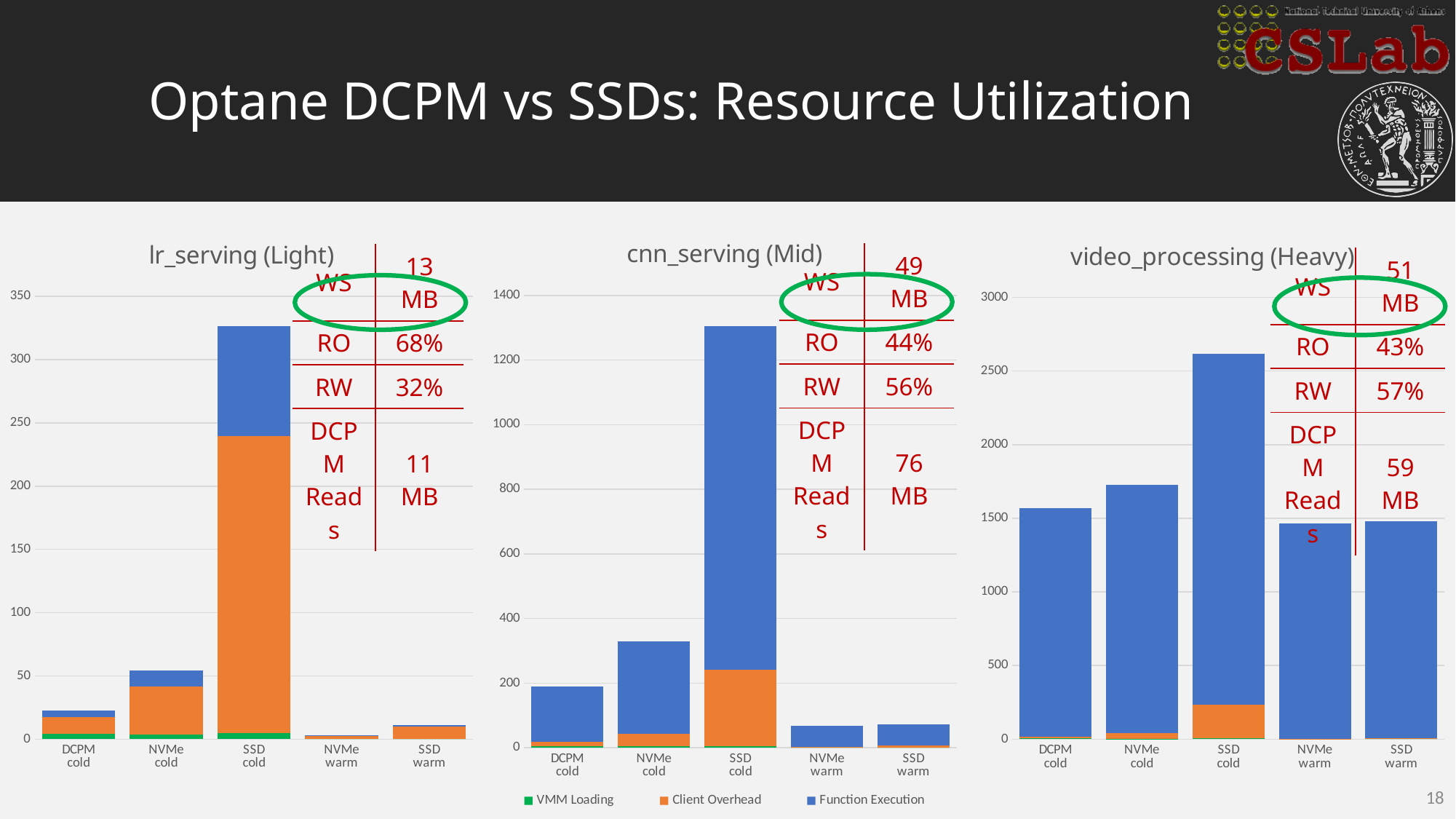
In the cnn_serving (Mid) chart, which bar is taller: DCPM cold or NVMe cold? NVMe cold In the video_processing (Heavy) chart, which category has the tallest bar? SSD cold In the lr_serving (Light) chart, which category has the tallest bar? SSD cold In the lr_serving (Light) chart, is the total for DCPM cold greater or less than 50? less In the cnn_serving (Mid) chart, is the total for NVMe cold greater or less than 400? less In the video_processing (Heavy) chart, which bar is taller: DCPM cold or NVMe cold? NVMe cold In the cnn_serving (Mid) chart, which category has the tallest bar? SSD cold How many series does the legend list for the charts on this slide? 3 In the lr_serving (Light) chart, is the total for SSD cold greater or less than 300? greater How many categories are shown on the x axis of the lr_serving (Light) chart? 5